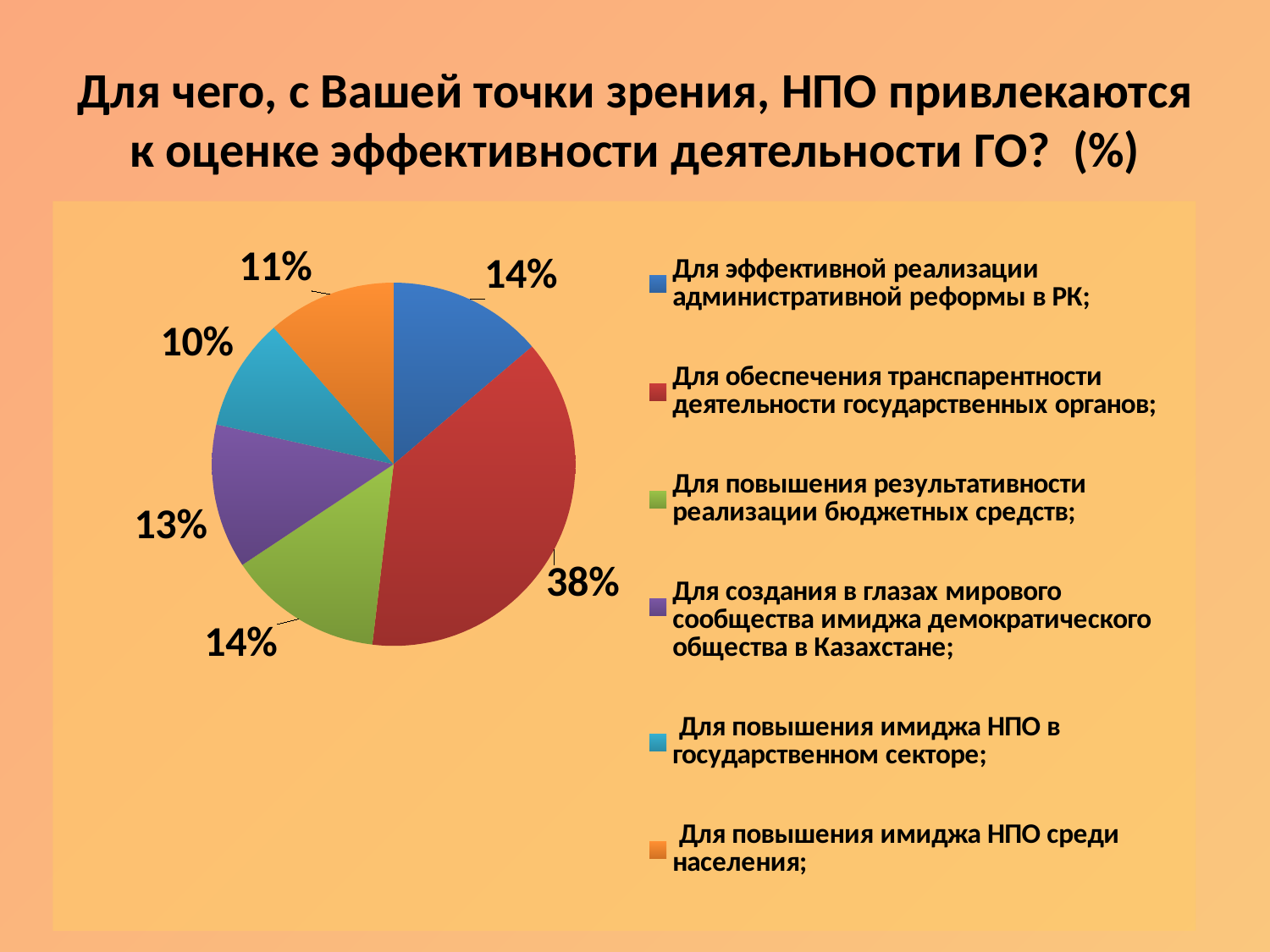
What percentage is shown for the slice "Для обеспечения транспарентности деятельности государственных органов"? 38% Which has the larger share: "Для создания в глазах мирового сообщества имиджа демократического общества в Казахстане" or "Для повышения имиджа НПО в государственном секторе"? Для создания в глазах мирового сообщества имиджа демократического общества в Казахстане Which category has the smallest share of the pie? Для повышения имиджа НПО в государственном секторе What percentage is shown for the slice "Для повышения имиджа НПО в государственном секторе"? 10% How many percentage points larger is the share for "Для обеспечения транспарентности деятельности государственных органов" than the share for "Для эффективной реализации административной реформы в РК"? 24 percentage points How many slices does the pie chart have? 6 What percentage is shown for the slice "Для повышения имиджа НПО среди населения"? 11% What percentage is shown for the slice "Для создания в глазах мирового сообщества имиджа демократического общества в Казахстане"? 13% What colour is the slice labelled 38%? Red How many percentage points larger is the share for "Для повышения имиджа НПО среди населения" than the share for "Для повышения имиджа НПО в государственном секторе"? 1 percentage point Which category has the largest share of the pie? Для обеспечения транспарентности деятельности государственных органов What kind of chart is shown on the slide? Pie chart